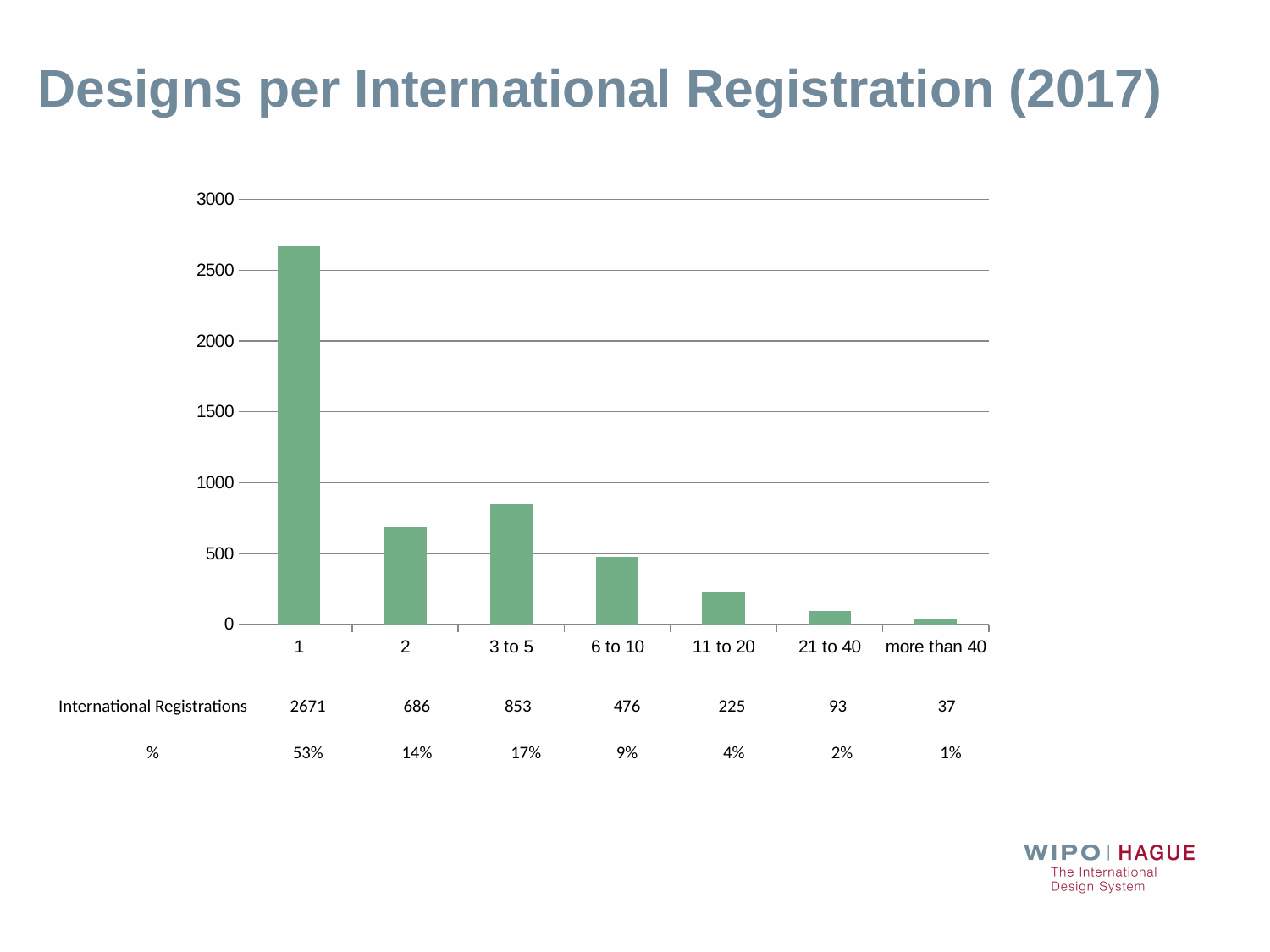
What percentage of international registrations had 6 to 10 designs? 9% Which has more international registrations: '6 to 10' or '11 to 20'? 6 to 10 What is the difference in international registrations between the '3 to 5' and '2' categories? 167 How many categories are shown on the x axis? 7 What is the title of the slide? Designs per International Registration (2017) How many international registrations had more than 40 designs? 37 Is the value for '2' greater or less than 500? greater Which category has the lowest number of international registrations? more than 40 Which category has the highest number of international registrations? 1 How many international registrations had 1 design? 2671 How many international registrations had 3 to 5 designs? 853 What kind of chart is shown on the slide? bar chart